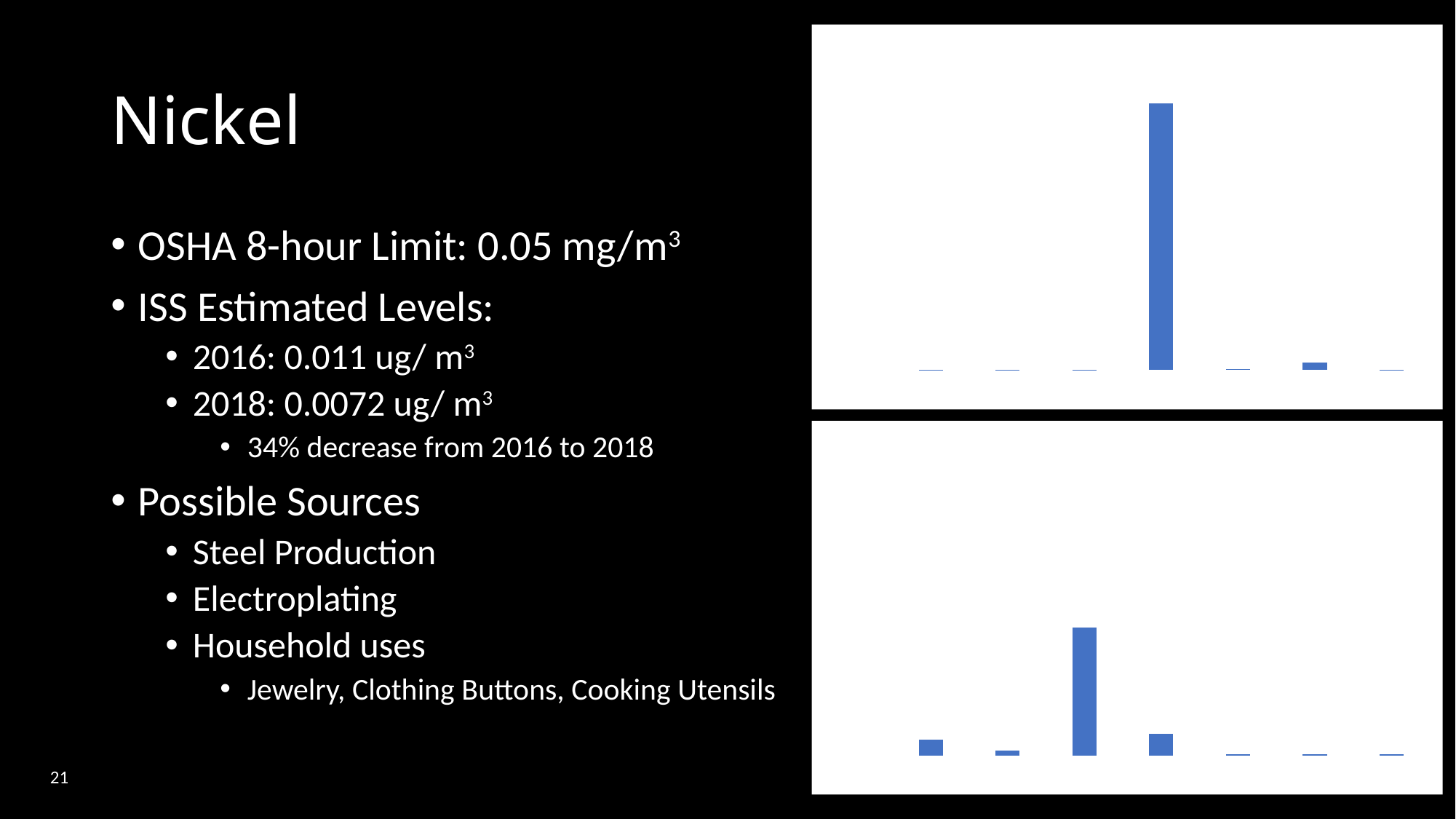
In the bottom chart, which is taller: the third bar from the left or the fourth bar from the left? the third bar In the top chart, which bar (counting from the left) is the tallest? the fourth bar In the top chart, which is taller: the first bar from the left or the sixth bar from the left? the sixth bar In the bottom chart, how many bars are plotted? 7 What kind of chart is the top chart on the right of the slide? bar chart What colour are the bars in both charts on the slide? blue What kind of chart is the bottom chart on the right of the slide? bar chart In the top chart, how many bars are plotted? 7 In the bottom chart, which is taller: the first bar from the left or the second bar from the left? the first bar In the bottom chart, which bar (counting from the left) is the tallest? the third bar How many charts are shown on the slide? 2